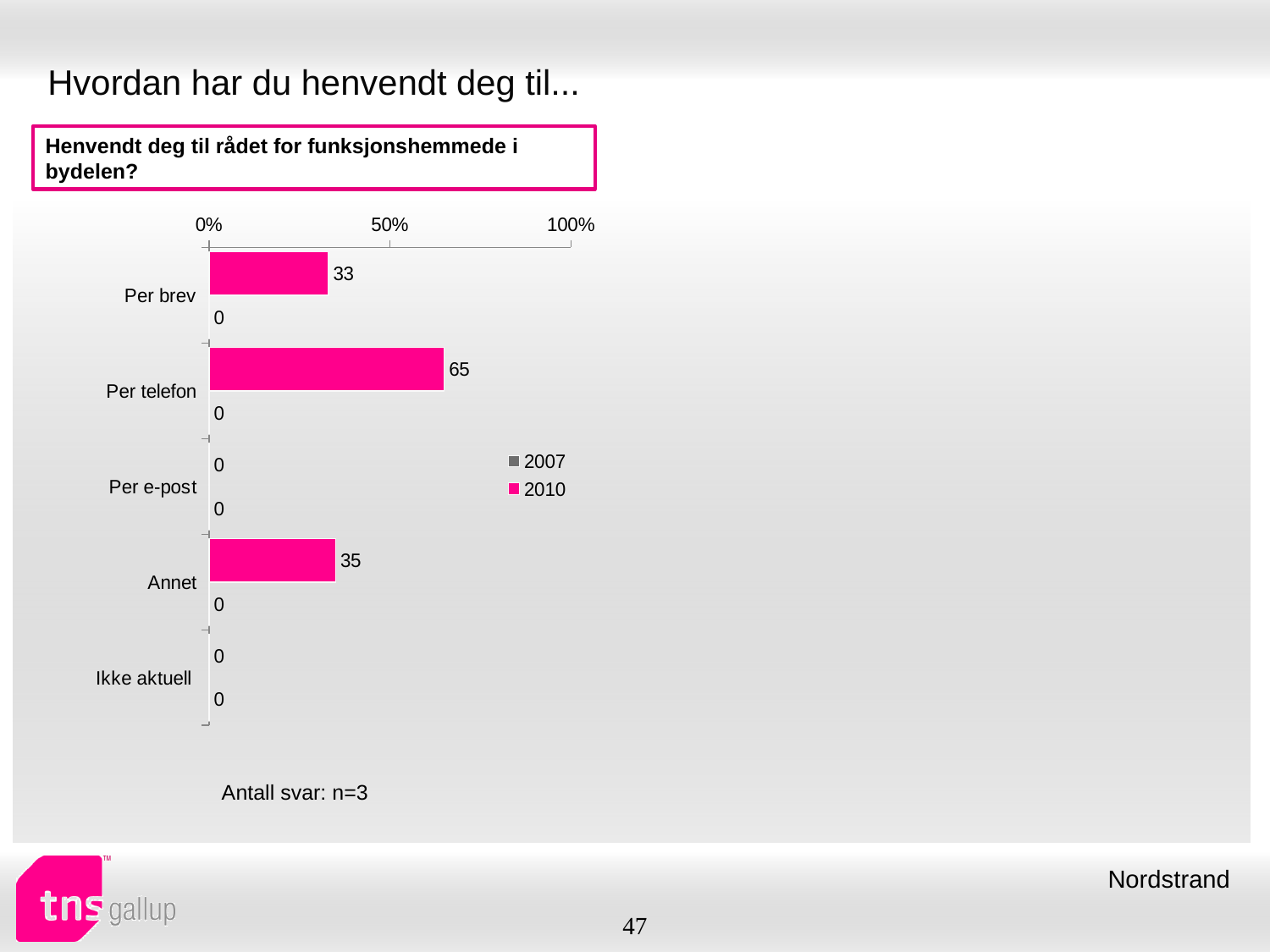
Which colour represents the 2010 series in the legend? pink What kind of chart is shown on the slide? bar chart What is the 2010 value for Per telefon? 65 How many categories are shown on the chart? 5 What is the 2007 value for Per telefon? 0 How many series does the legend list? 2 Which has a larger 2010 value, Annet or Per brev? Annet Is the 2010 value for Per telefon greater or less than 50%? greater Which category has the highest 2010 value? Per telefon What is the 2010 value for Per brev? 33 What is the difference between the 2010 values for Per telefon and Per brev? 32 What is the 2010 value for Annet? 35